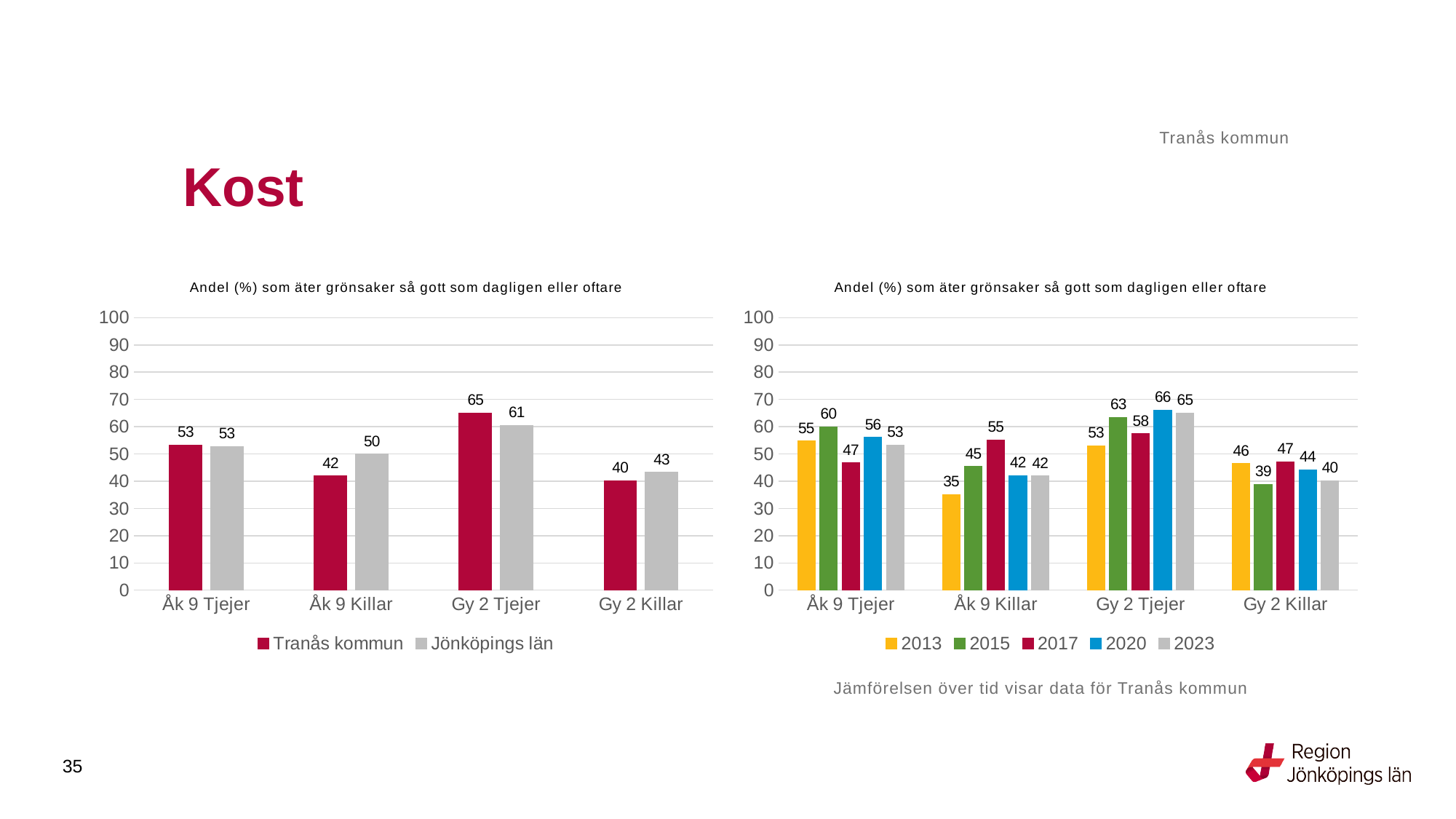
In the right chart, which is larger for Åk 9 Tjejer: 2015 or 2023? 2015 In the right chart, which year has the highest value for Gy 2 Tjejer? 2020 What kind of chart is the left chart? Bar chart In the right chart, what is the value for 2013 for Gy 2 Killar? 46 In the left chart, what is the value for Tranås kommun for Gy 2 Tjejer? 65 In the left chart, what is the value for Jönköpings län for Åk 9 Killar? 50 In the left chart, which category has the lowest value for Tranås kommun? Gy 2 Killar In the left chart, what is the difference between Tranås kommun and Jönköpings län for Åk 9 Killar? 8 In the right chart, what is the difference between the 2013 and 2017 values for Åk 9 Killar? 20 In the right chart, what is the value for 2017 for Åk 9 Killar? 55 In the left chart, how many series does the legend list? 2 In the right chart, how many series does the legend list? 5